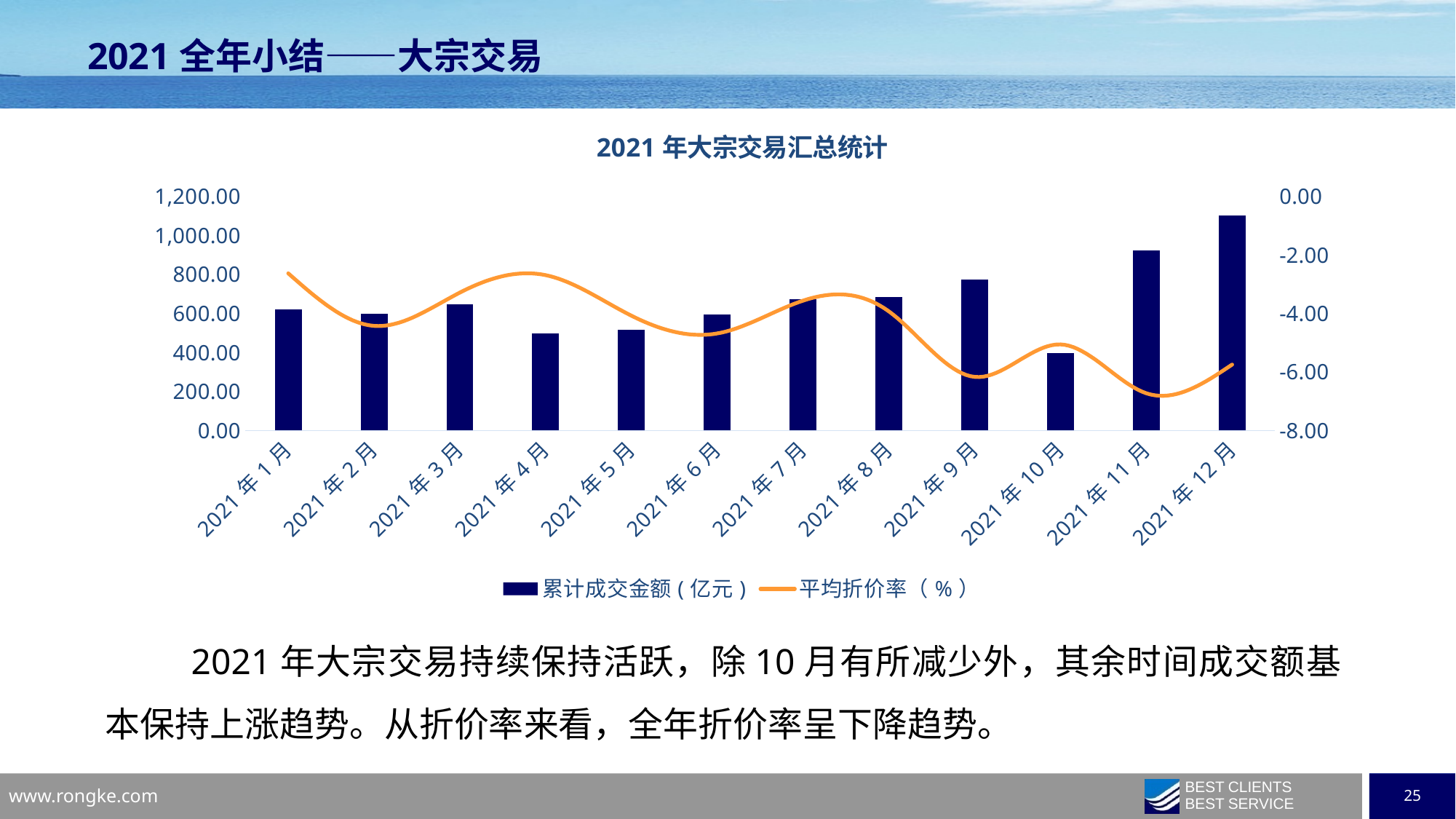
Is the 累计成交金额 value for 2021 年 12 月 greater or less than 1,000.00? greater What is the title of the chart? 2021 年大宗交易汇总统计 Which month has the lowest 累计成交金额 bar? 2021 年 10 月 Does the 平均折价率 line generally rise or fall from January to December? fall How many series does the legend list? 2 Which is larger, the 累计成交金额 bar for 2021 年 9 月 or for 2021 年 4 月? 2021 年 9 月 Which month has the highest 累计成交金额 bar? 2021 年 12 月 Is the 平均折价率 value for 2021 年 11 月 greater or less than -6.00? less Is the 累计成交金额 value for 2021 年 10 月 greater or less than 600.00? less How many months are shown on the x axis? 12 What kind of chart is shown on the slide? Combined bar and line chart